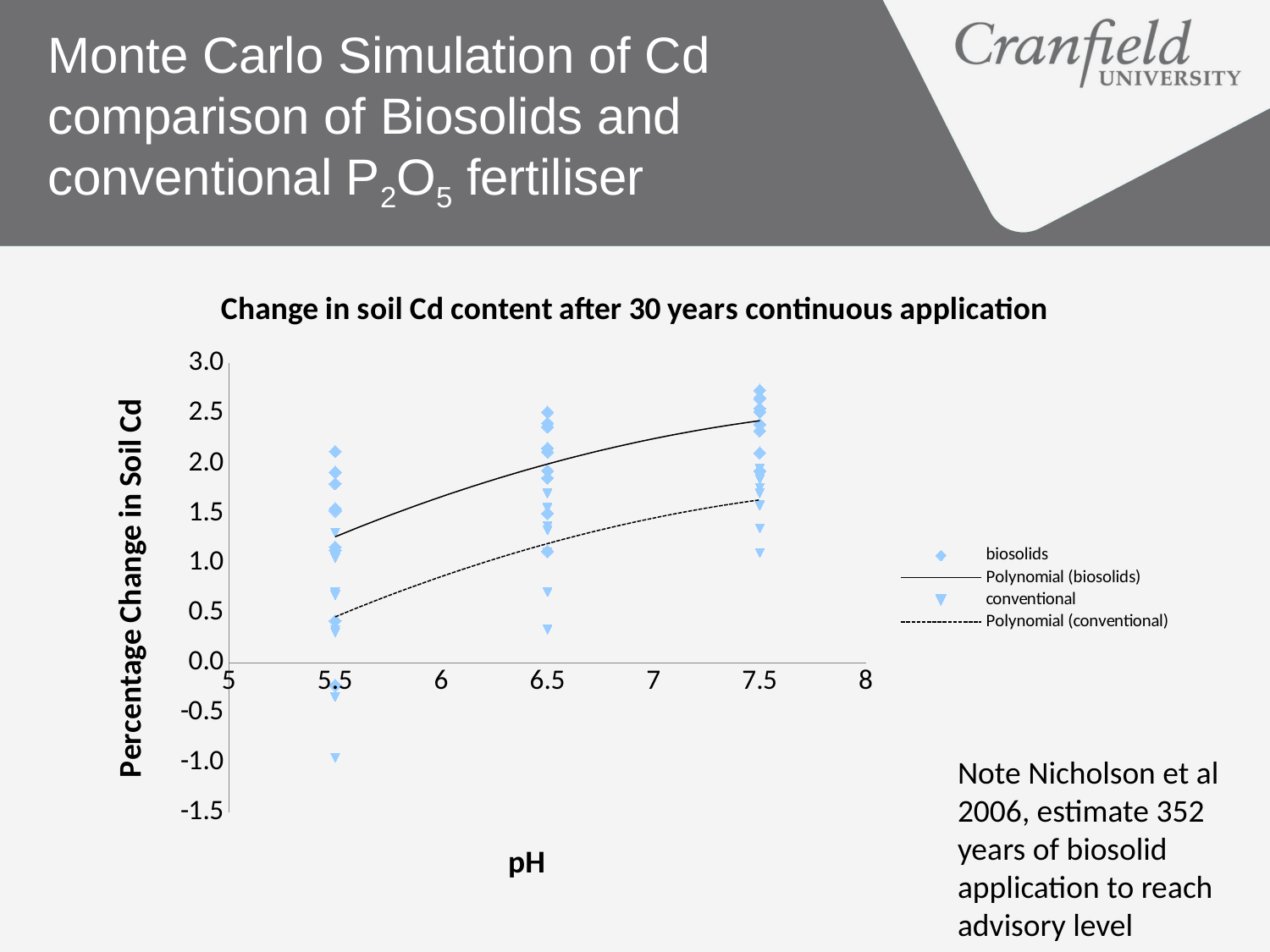
Is the highest biosolids data point at pH 7.5 greater or less than 2.5? greater Is the lowest conventional data point at pH 5.5 greater or less than -0.5? less At how many distinct pH values are data points plotted? 3 Is the highest biosolids data point at pH 5.5 greater or less than 2.5? less What is the label of the x axis? pH Does the polynomial trendline for conventional fertiliser rise or fall as pH increases? Rises How many entries does the chart legend list? 4 Does the polynomial trendline for biosolids rise or fall as pH increases? Rises What is the title of the chart? Change in soil Cd content after 30 years continuous application Which series has the higher polynomial trendline across the pH range, biosolids or conventional? Biosolids What kind of chart is shown on the slide? Scatter chart